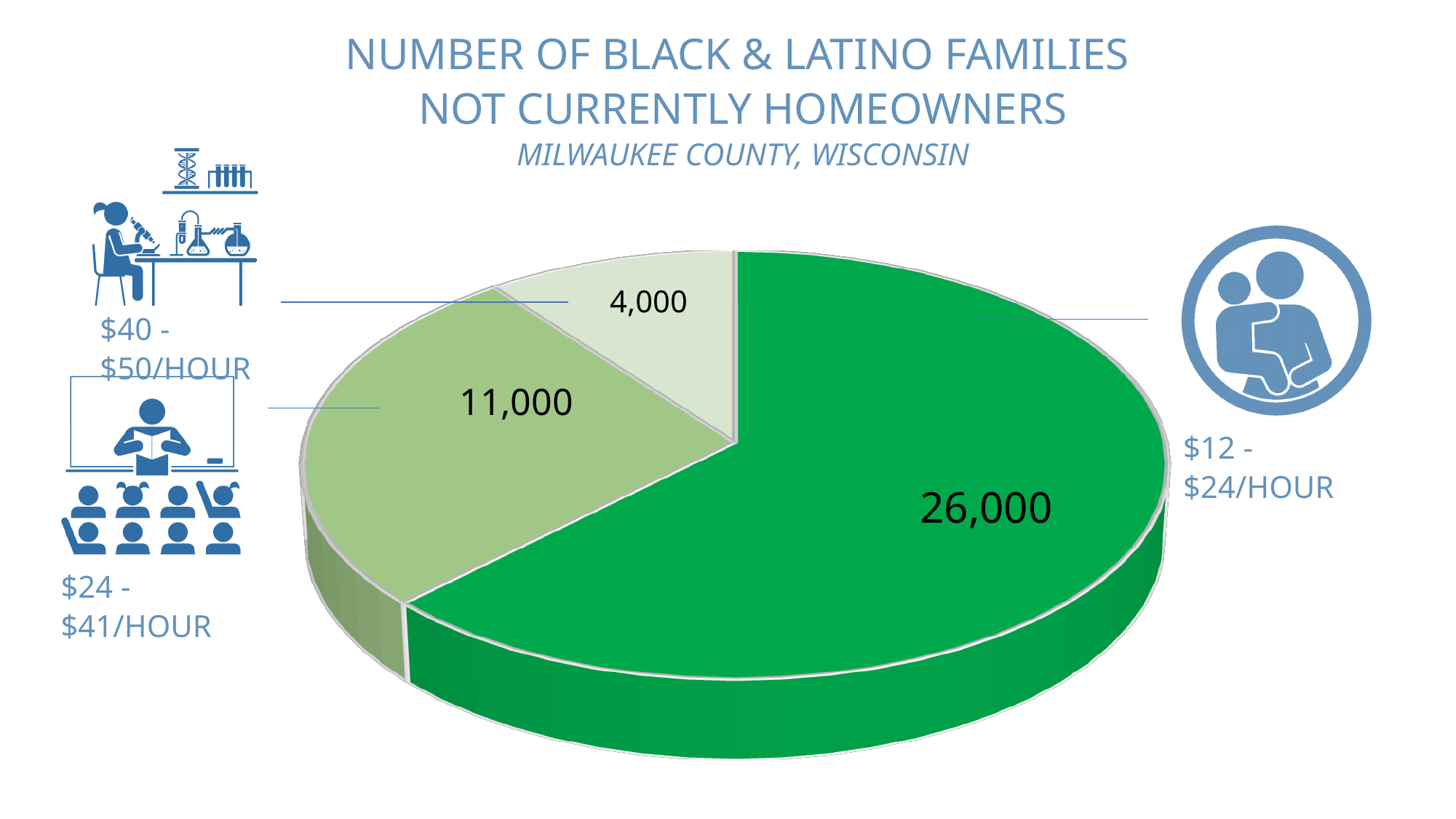
What type of chart is shown on the slide? pie chart Which wage group has the smallest number of families? $40 - $50/hour What is the total number of families across all three wage groups? 41,000 What is the difference between the $24 - $41/hour group and the $40 - $50/hour group? 7,000 What is the number of families in the $12 - $24/hour group? 26,000 What is the number of families in the $40 - $50/hour group? 4,000 Which county and state does the chart title say the data is for? Milwaukee County, Wisconsin Which wage group has the largest number of families? $12 - $24/hour How many more families are in the $12 - $24/hour group than in the $24 - $41/hour group? 15,000 What is the number of families in the $24 - $41/hour group? 11,000 How many slices does the pie chart have? 3 Which is larger, the $24 - $41/hour group or the $40 - $50/hour group? $24 - $41/hour